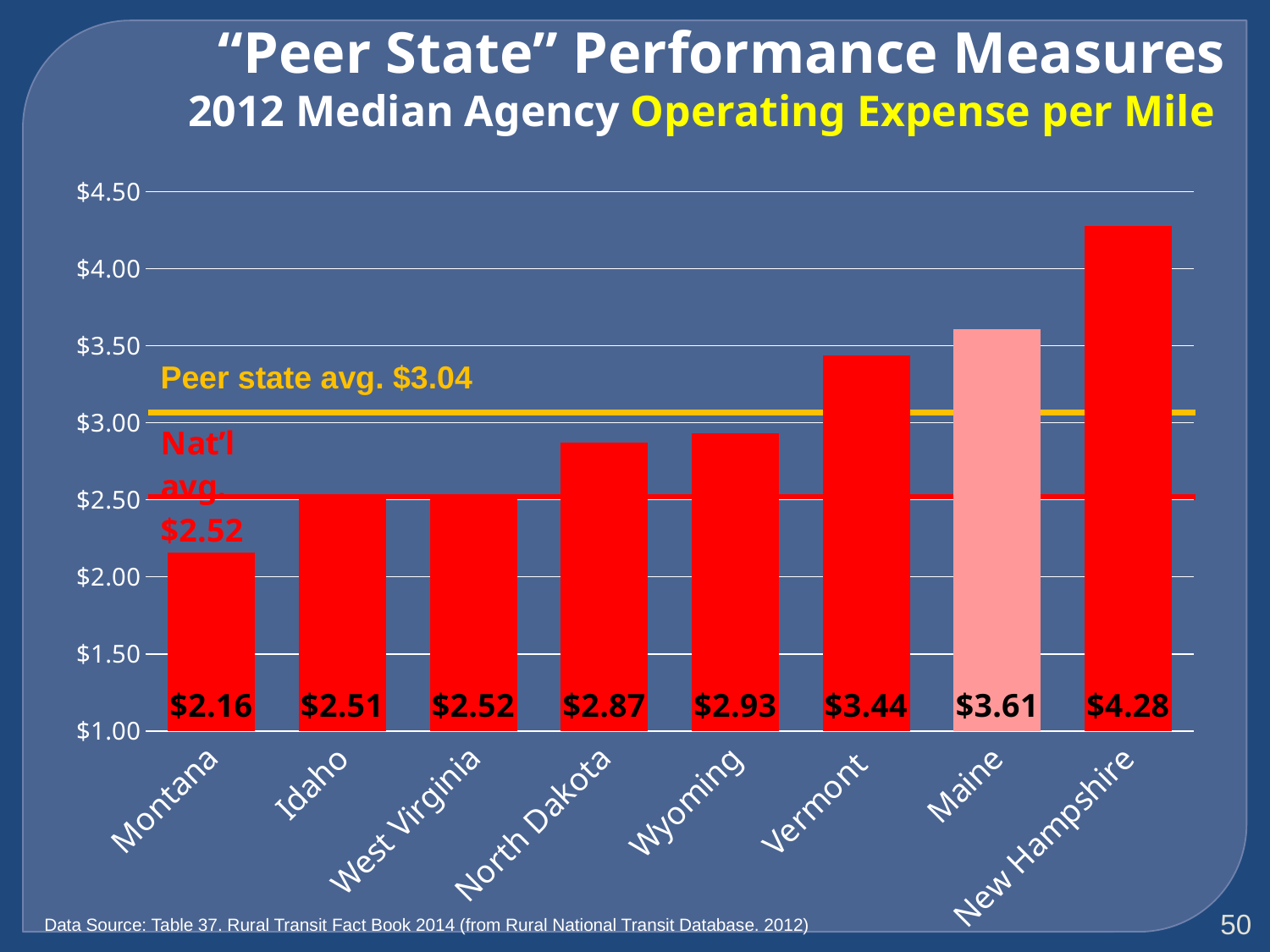
What kind of chart is shown on the slide? Bar chart Which state has the highest operating expense per mile? New Hampshire Which state's bar is shown in a lighter pink colour than the others? Maine What is the difference between New Hampshire's and Montana's operating expense per mile? $2.12 What is the operating expense per mile shown for North Dakota? $2.87 How many states are shown in the chart? 8 Which has a higher operating expense per mile, Vermont or Wyoming? Vermont Is the value for Idaho greater or less than $3.00? less Which state has the lowest operating expense per mile? Montana Do the values rise or fall moving from left to right across the states? Rise What is the peer state average operating expense per mile shown on the chart? $3.04 What is the 2012 median agency operating expense per mile for Maine? $3.61